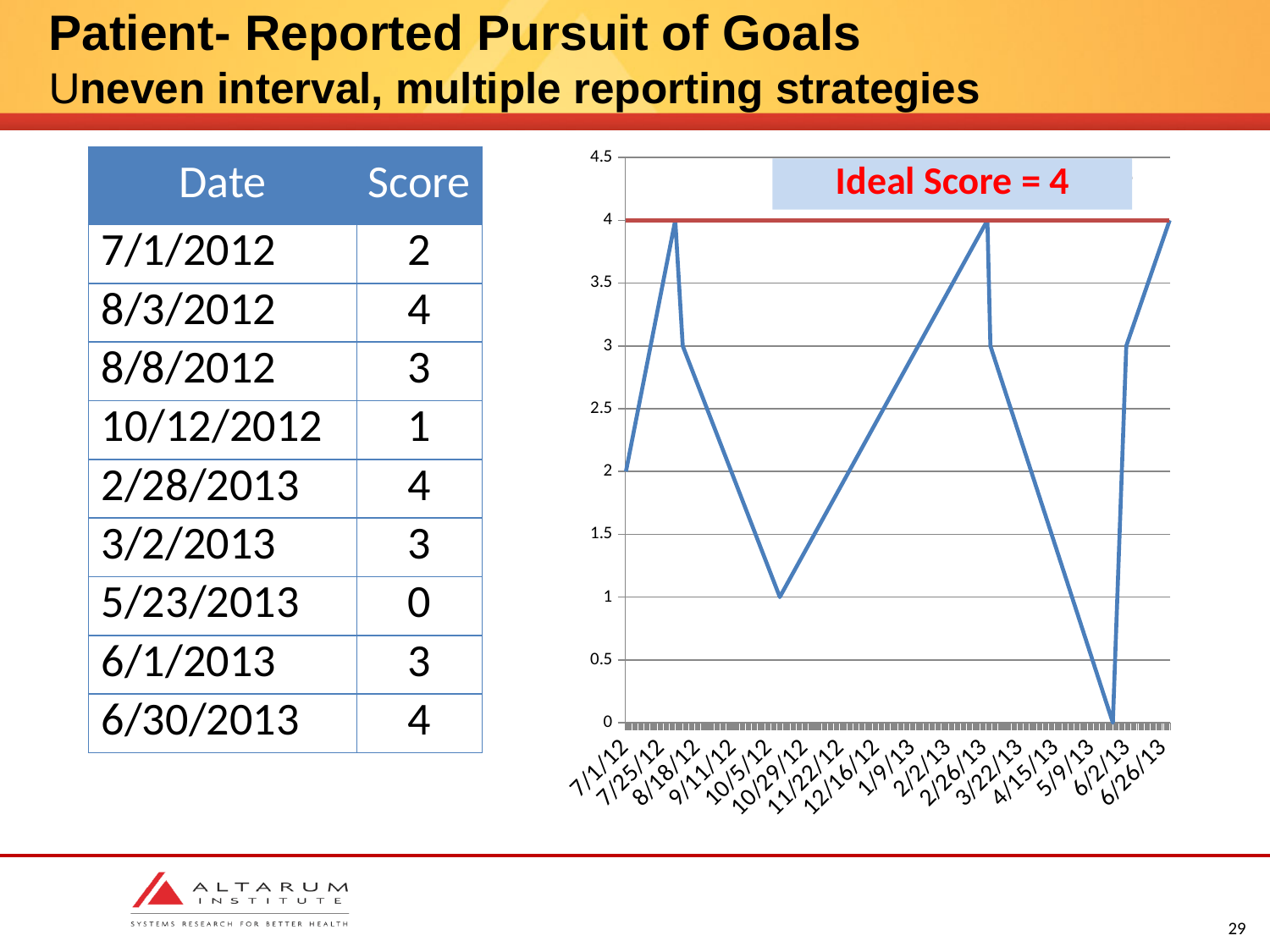
Which date has the larger score, 6/1/2013 or 6/30/2013? 6/30/2013 Do the scores rise or fall from 5/23/2013 to 6/30/2013? rise Is the score for 2/28/2013 greater or less than 2? greater What is the highest score value reached on the chart? 4 What is the difference between the score on 8/3/2012 and the score on 8/8/2012? 1 What score is plotted for 3/2/2013? 3 What value does the red horizontal line on the chart mark as the ideal score? 4 How many data points are plotted on the line chart? 9 What kind of chart is shown on the slide? line chart On which date is the lowest score plotted? 5/23/2013 What score is plotted for 10/12/2012? 1 What score is plotted for 7/1/2012? 2